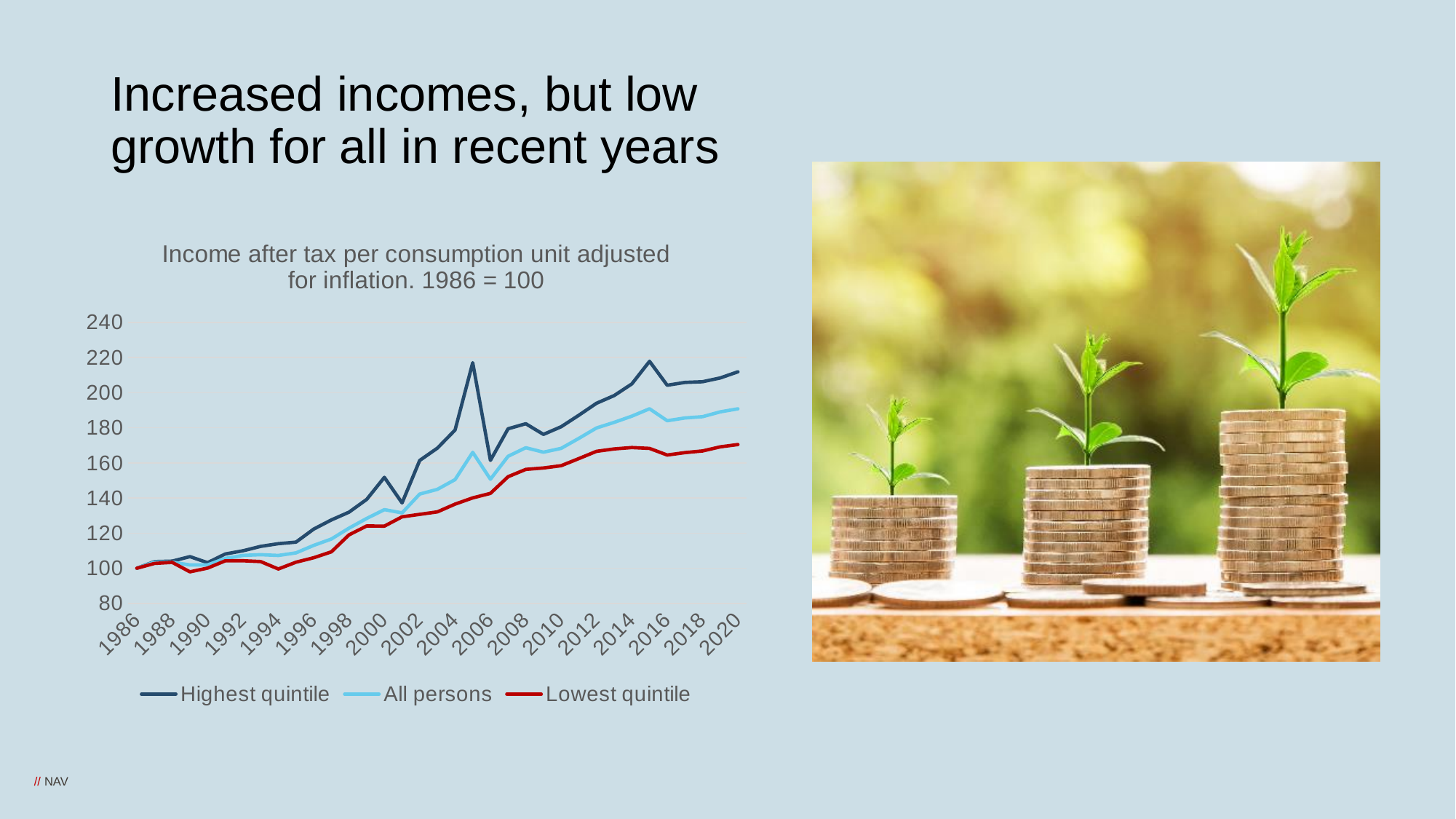
Which series has the highest value in 2020? Highest quintile Is the value for the Highest quintile in 2020 greater or less than 200? greater How many series does the chart legend list? 3 What type of chart is shown on the slide? line chart Is the value for the Lowest quintile in 2020 greater or less than 180? less What are the three series listed in the chart legend? Highest quintile, All persons, Lowest quintile Is the value for All persons in 2020 greater or less than 180? greater What is the title of the chart? Income after tax per consumption unit adjusted for inflation. 1986 = 100 Which series has the lowest value in 2020? Lowest quintile What index value does the chart assign to the base year 1986? 100 In 2010, which is larger: the value for All persons or the value for the Lowest quintile? All persons Do the values for the Highest quintile series generally rise or fall from 1986 to 2020? rise